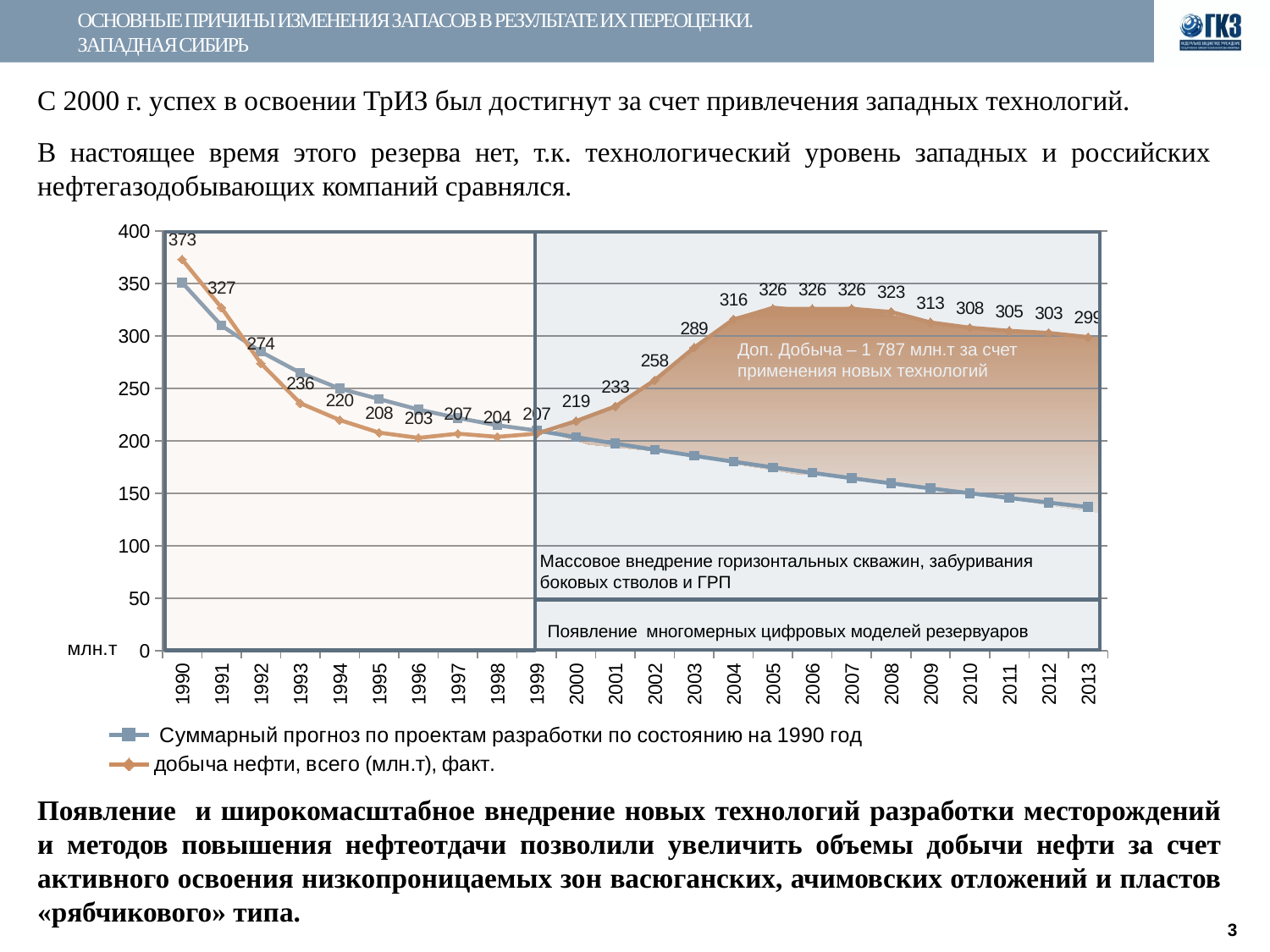
How many series does the chart legend list? 2 What is the actual oil production value for 2013? 299 In which year is the actual oil production (факт.) series at its highest? 1990 How many years are shown on the x axis of the chart? 24 Which year has the higher actual oil production value, 2004 or 2009? 2004 What is the difference between the actual oil production in 2005 and in 2000? 107 In which year is the actual oil production (факт.) series at its lowest? 1996 Is the value of the 1990 forecast series (Суммарный прогноз) for 2013 greater or less than 150? less What type of chart is shown on the slide? Line chart What is the actual oil production value for 2002? 258 Is the value of the 1990 forecast series (Суммарный прогноз) for 2005 greater or less than 200? less What is the actual oil production value (добыча нефти, всего, факт.) for 1990? 373